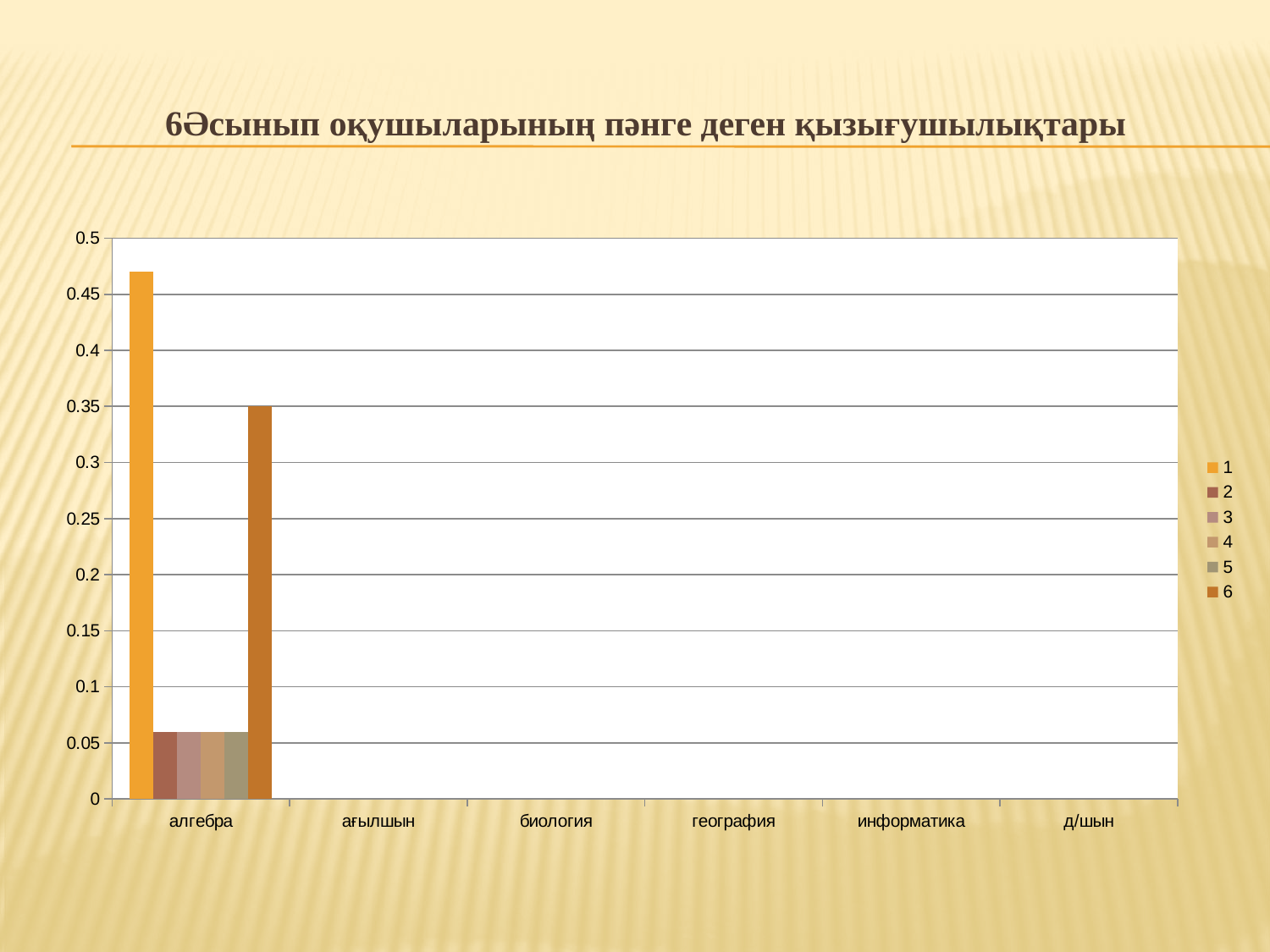
What is the title of the slide? 6Әсынып оқушыларының пәнге деген қызығушылықтары Which series has the highest value for алгебра? 1 Is the value of series 1 for алгебра greater or less than 0.5? less What kind of chart is shown on the slide? bar chart How many categories are shown on the x axis of the chart? 6 What is the value of series 6 for алгебра? 0.35 How many series does the legend list? 6 Is the value of series 1 for алгебра greater or less than 0.45? greater For алгебра, which is larger: series 1 or series 6? 1 Is the value of series 2 for алгебра greater or less than 0.1? less Which category is the only one with visible bars in the chart? алгебра For алгебра, which is larger: series 6 or series 3? 6